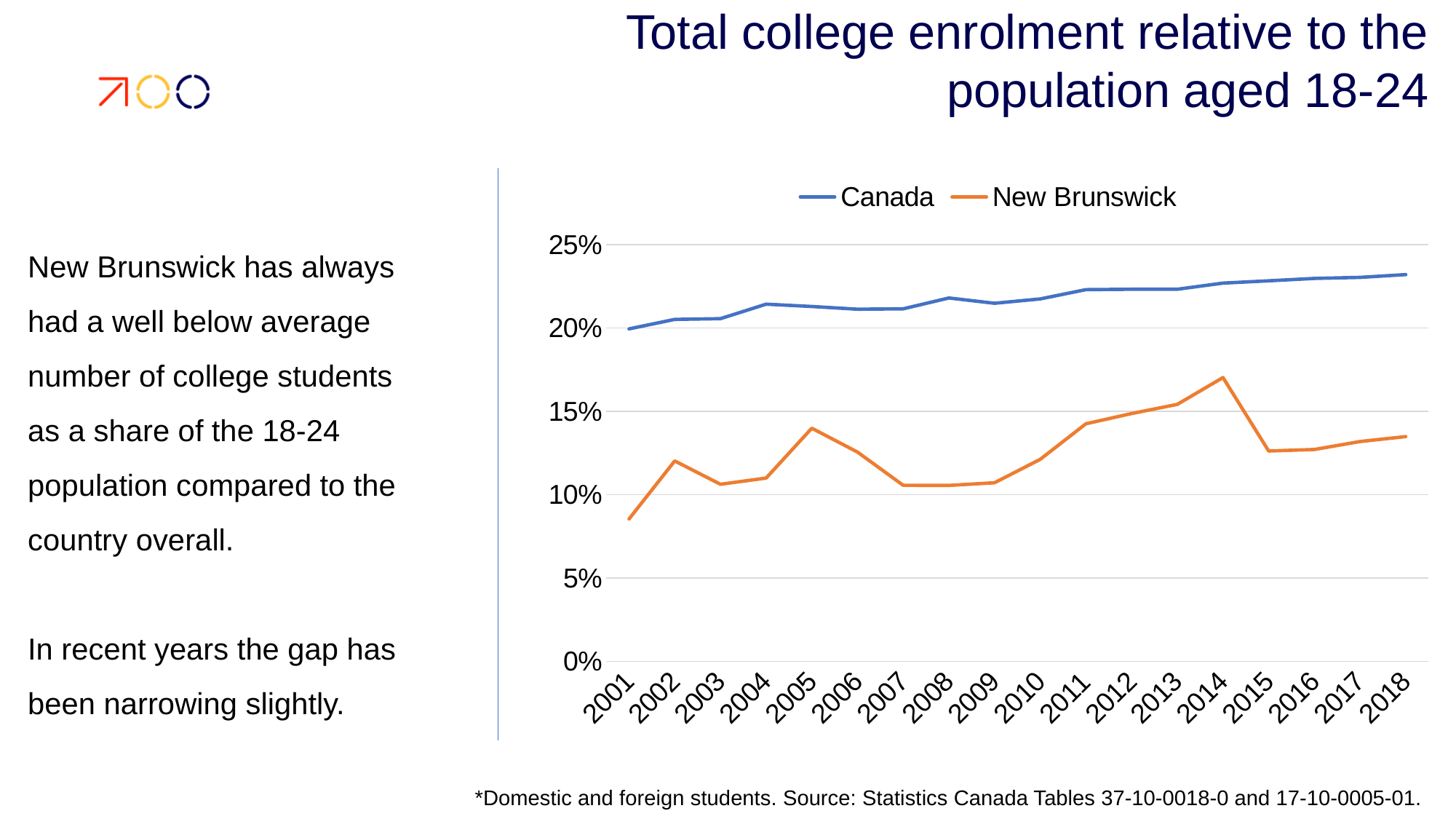
In 2010, which series has the larger value, Canada or New Brunswick? Canada What colour is the line for New Brunswick? orange Is the value for Canada in 2018 greater or less than 25%? less In which year does the New Brunswick series reach its highest value? 2014 In which year is the New Brunswick series at its lowest value? 2001 Is the value for New Brunswick in 2001 greater or less than 10%? less Does the Canada series generally rise or fall from 2001 to 2018? rise Is the value for New Brunswick in 2014 greater or less than 15%? greater What kind of chart is shown on the slide? line chart How many series does the legend list? 2 How many years are plotted along the x axis? 18 In which year is the Canada series at its lowest value? 2001